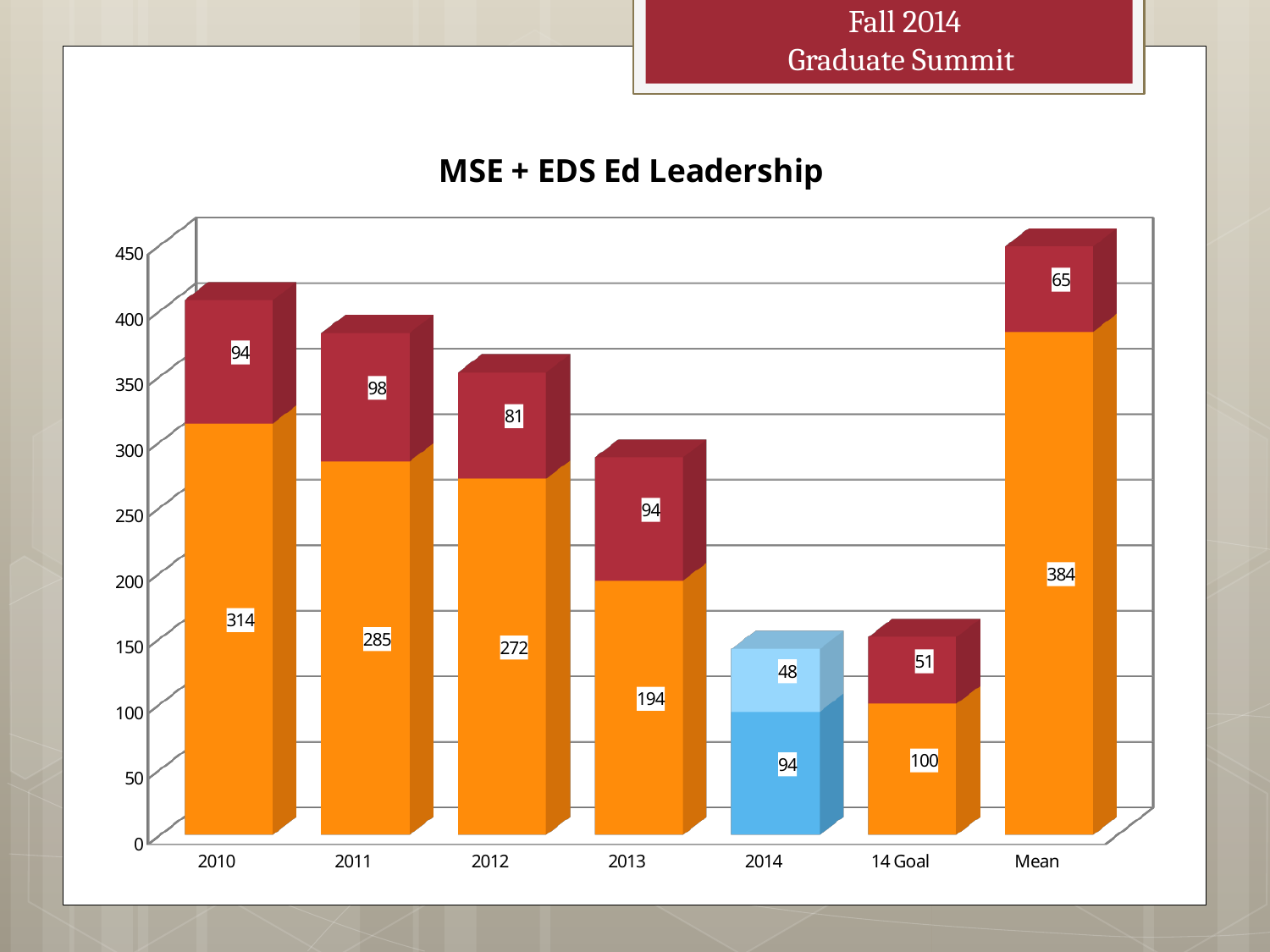
What is the value of the bottom segment for the Mean bar? 384 What is the value of the top (red) segment for 2012? 81 What is the total of the stacked bar for 2014? 142 Which category has the highest total bar? Mean What is the title of the chart? MSE + EDS Ed Leadership What is the difference between the bottom segment values for 2011 and 2012? 13 What kind of chart is shown on the slide? stacked bar chart Is the bottom segment value for 2010 larger than the bottom segment value for 2013? Yes What is the total of the stacked bar for 2013? 288 What is the value of the bottom (orange) segment for 2010? 314 Which category has the lowest total bar? 2014 How many categories are shown on the x axis? 7